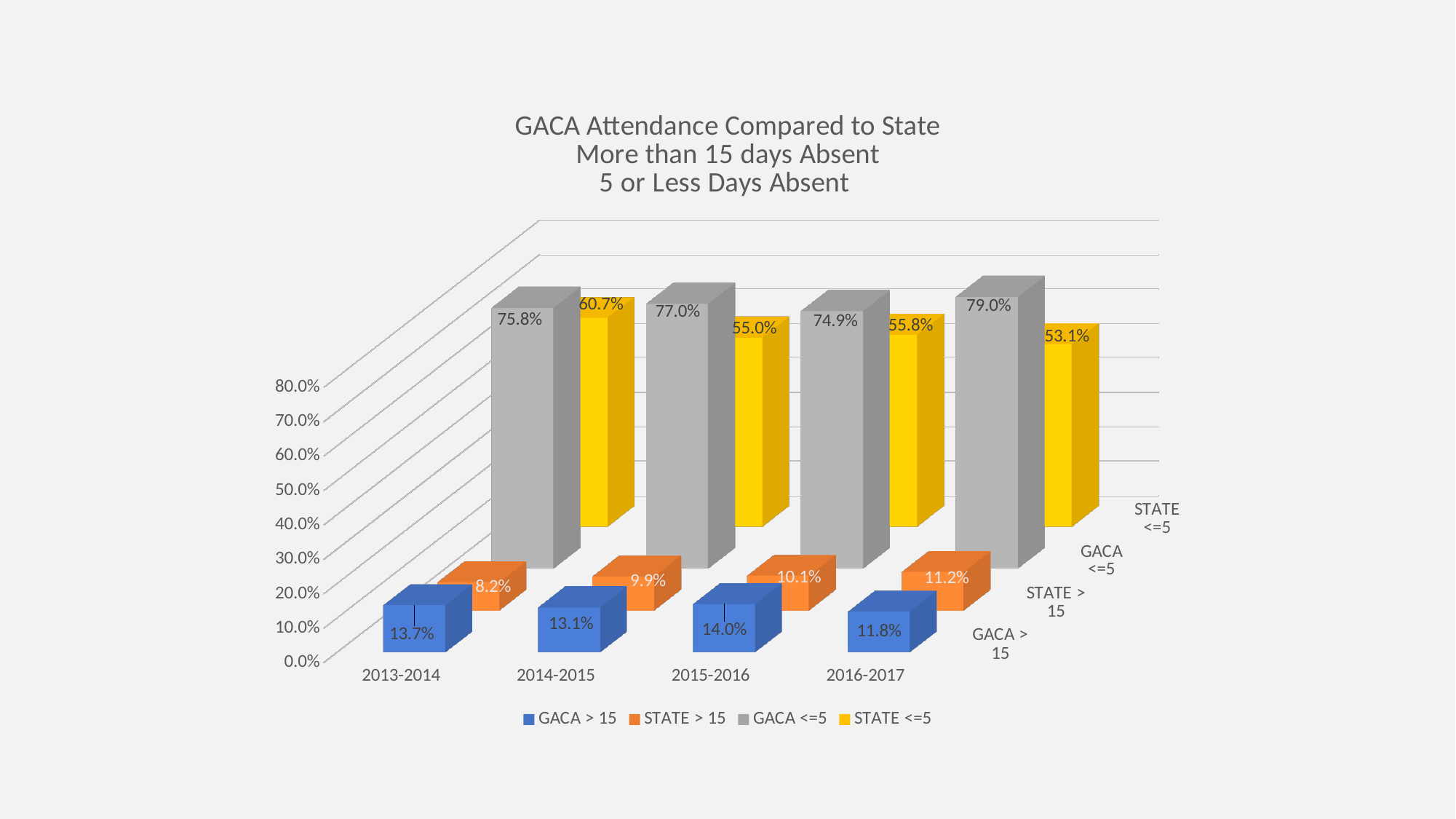
How many series does the legend list? 4 Which is larger in 2015-2016: GACA > 15 or STATE > 15? GACA > 15 What kind of chart is shown on the slide? Bar chart In which year is the STATE > 15 value lowest? 2013-2014 What is the value for GACA <=5 in 2015-2016? 74.9% How many school years are shown on the x axis? 4 In which year is the GACA <=5 value highest? 2016-2017 What is the difference between GACA <=5 and STATE <=5 in 2016-2017? 25.9% Does the STATE > 15 value rise or fall from 2013-2014 to 2016-2017? Rise What is the value for GACA > 15 in 2013-2014? 13.7% What is the value for STATE <=5 in 2016-2017? 53.1% What is the value for STATE > 15 in 2014-2015? 9.9%